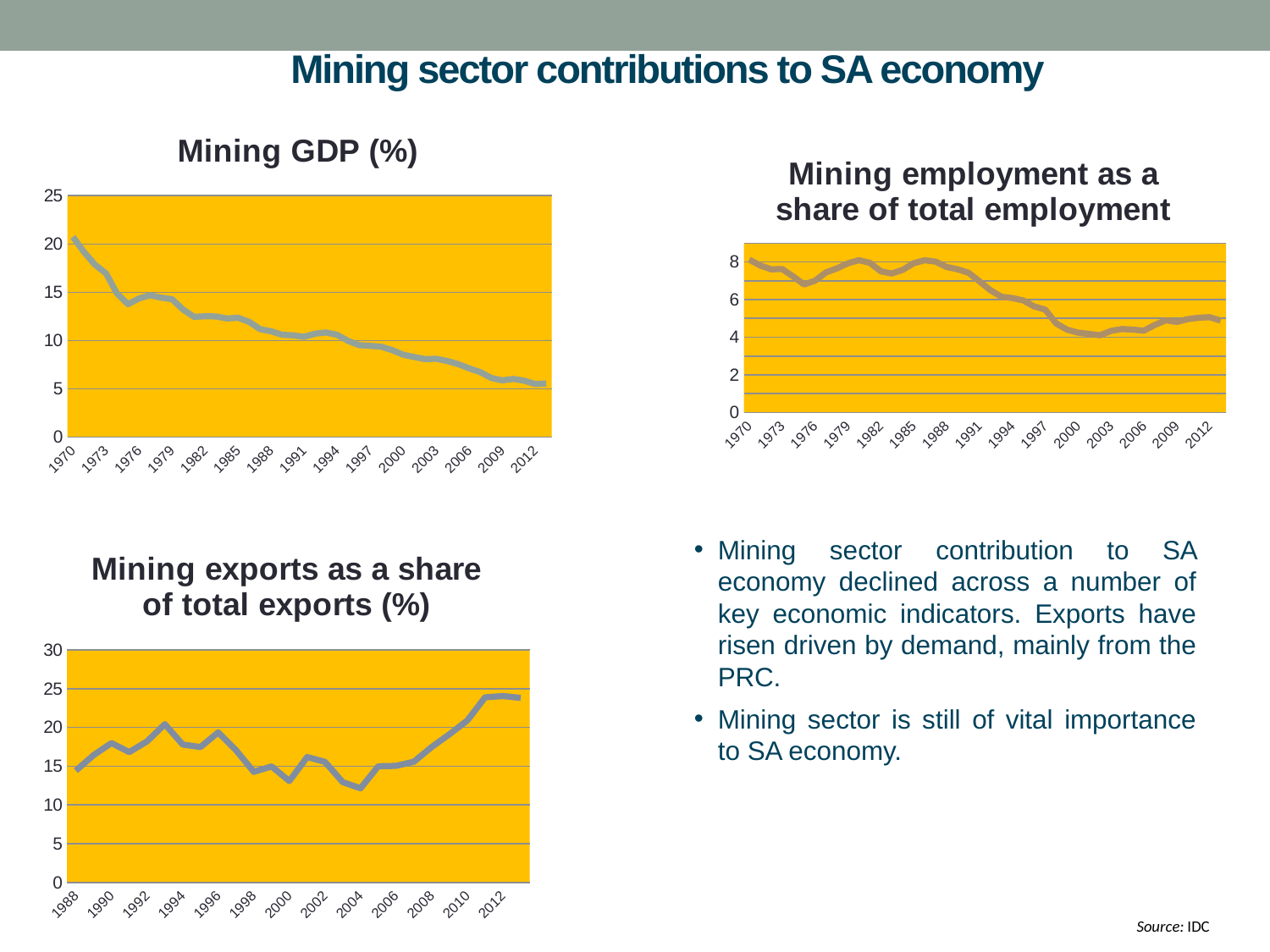
In the "Mining exports as a share of total exports (%)" chart, is the value for 2012 greater or less than 20? greater In the "Mining GDP (%)" chart, is the value for 2012 greater or less than 10? less In the "Mining employment as a share of total employment" chart, do the values rise or fall overall from 1970 to 2012? fall In the "Mining exports as a share of total exports (%)" chart, is the value for 2004 greater or less than 15? less What kind of chart is the "Mining GDP (%)" chart? line chart In the "Mining exports as a share of total exports (%)" chart, do the values rise or fall overall from 1988 to 2012? rise In the "Mining GDP (%)" chart, which year has the highest value? 1970 In the "Mining GDP (%)" chart, do the values rise or fall from 1970 to 2012? fall How many charts are shown on the slide? 3